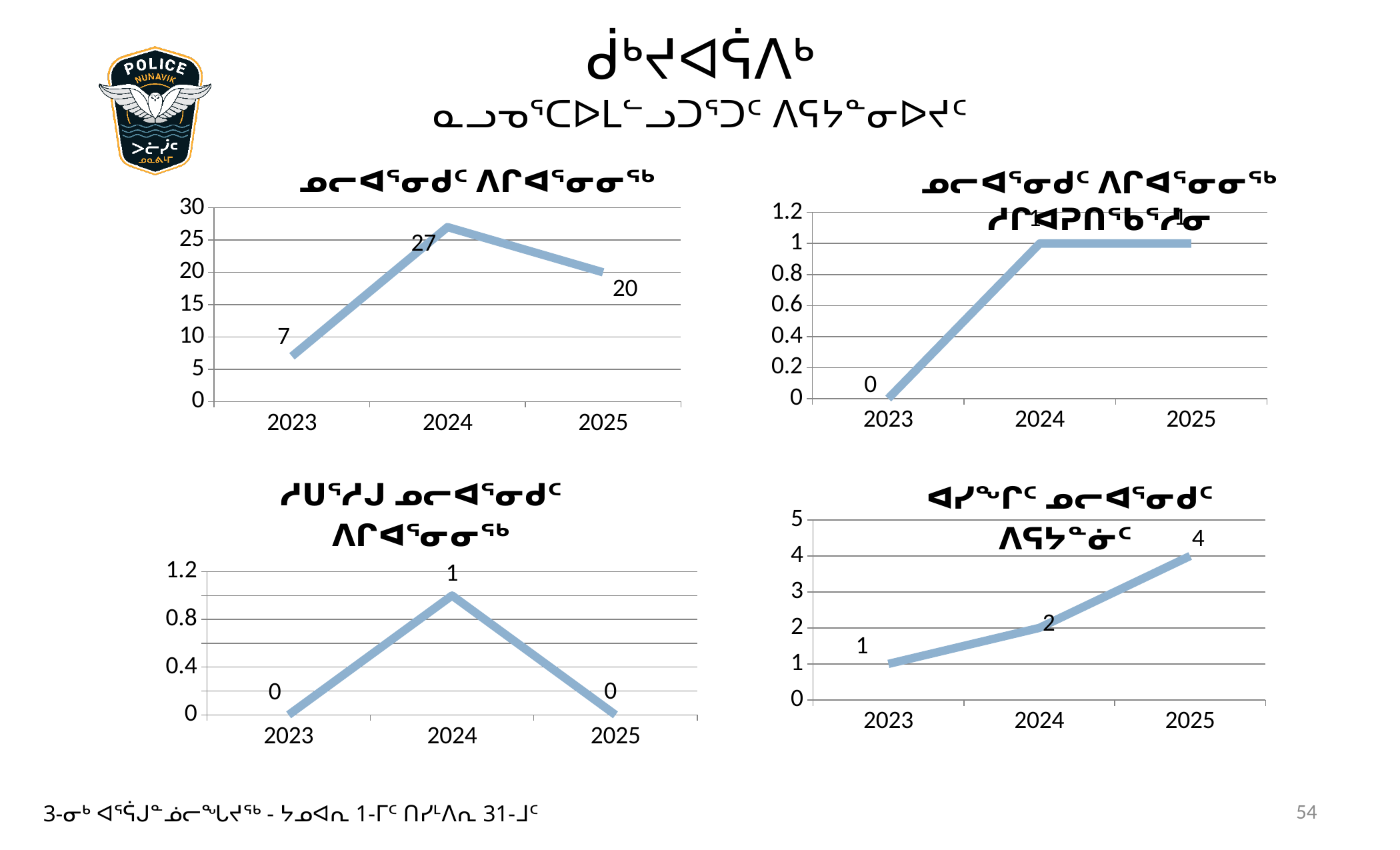
In the top-left chart, what is the difference between the 2024 and 2025 values? 7 In the top-left chart, what is the value for 2023? 7 In the bottom-right chart, what is the value for 2025? 4 In the top-left chart, is the value for 2025 greater or less than 15? greater In the top-left chart, which year has the lowest value? 2023 What kind of chart is the bottom-right chart? line chart In the top-left chart, which year has the highest value? 2024 In the top-right chart, what is the value for 2023? 0 In the top-left chart, what is the value for 2024? 27 In the bottom-right chart, do the values rise or fall from 2023 to 2025? rise In the bottom-left chart, which year has the highest value? 2024 In the bottom-left chart, what is the value for 2024? 1